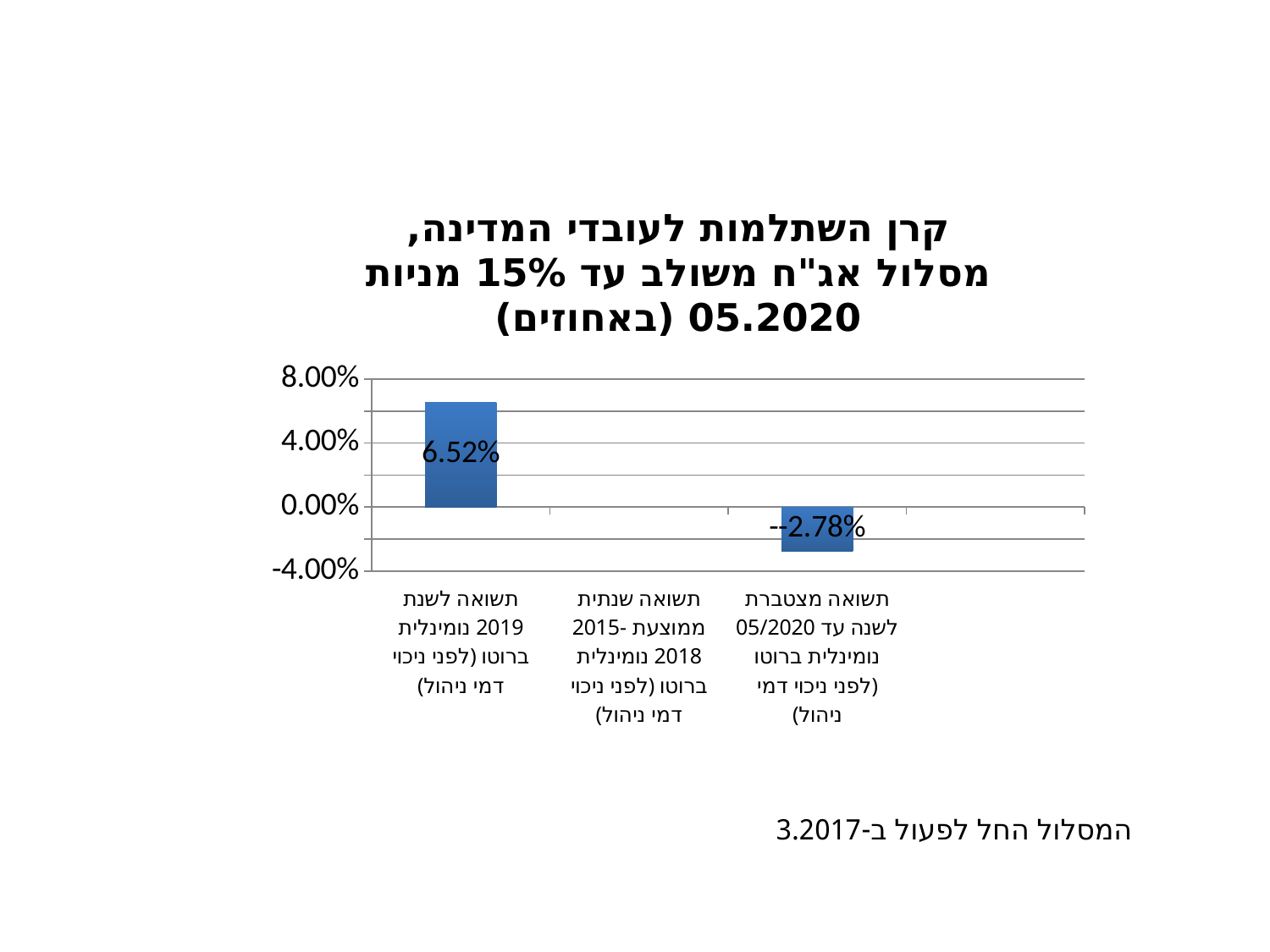
How many bars are actually plotted on the chart? 2 How many categories are labeled on the x axis? 3 Which plotted category has the lowest value? תשואה מצטברת לשנה עד 05/2020 נומינלית ברוטו (לפני ניכוי דמי ניהול) Which category has the highest value? תשואה לשנת 2019 נומינלית ברוטו (לפני ניכוי דמי ניהול) What is the value for 'תשואה לשנת 2019 נומינלית ברוטו (לפני ניכוי דמי ניהול)'? 6.52% What is the difference between the value for 'תשואה לשנת 2019' and the value for 'תשואה מצטברת לשנה עד 05/2020'? 9.30% Is the value for 'תשואה לשנת 2019 נומינלית ברוטו' greater or less than 4.00%? greater What kind of chart is shown on the slide? bar chart According to the note below the chart, when did the track start operating? 3.2017 Which is larger: the value for 'תשואה לשנת 2019' or the value for 'תשואה מצטברת לשנה עד 05/2020'? תשואה לשנת 2019 Is the value for 'תשואה מצטברת לשנה עד 05/2020' greater or less than 0.00%? less What is the value for 'תשואה מצטברת לשנה עד 05/2020 נומינלית ברוטו (לפני ניכוי דמי ניהול)'? -2.78%